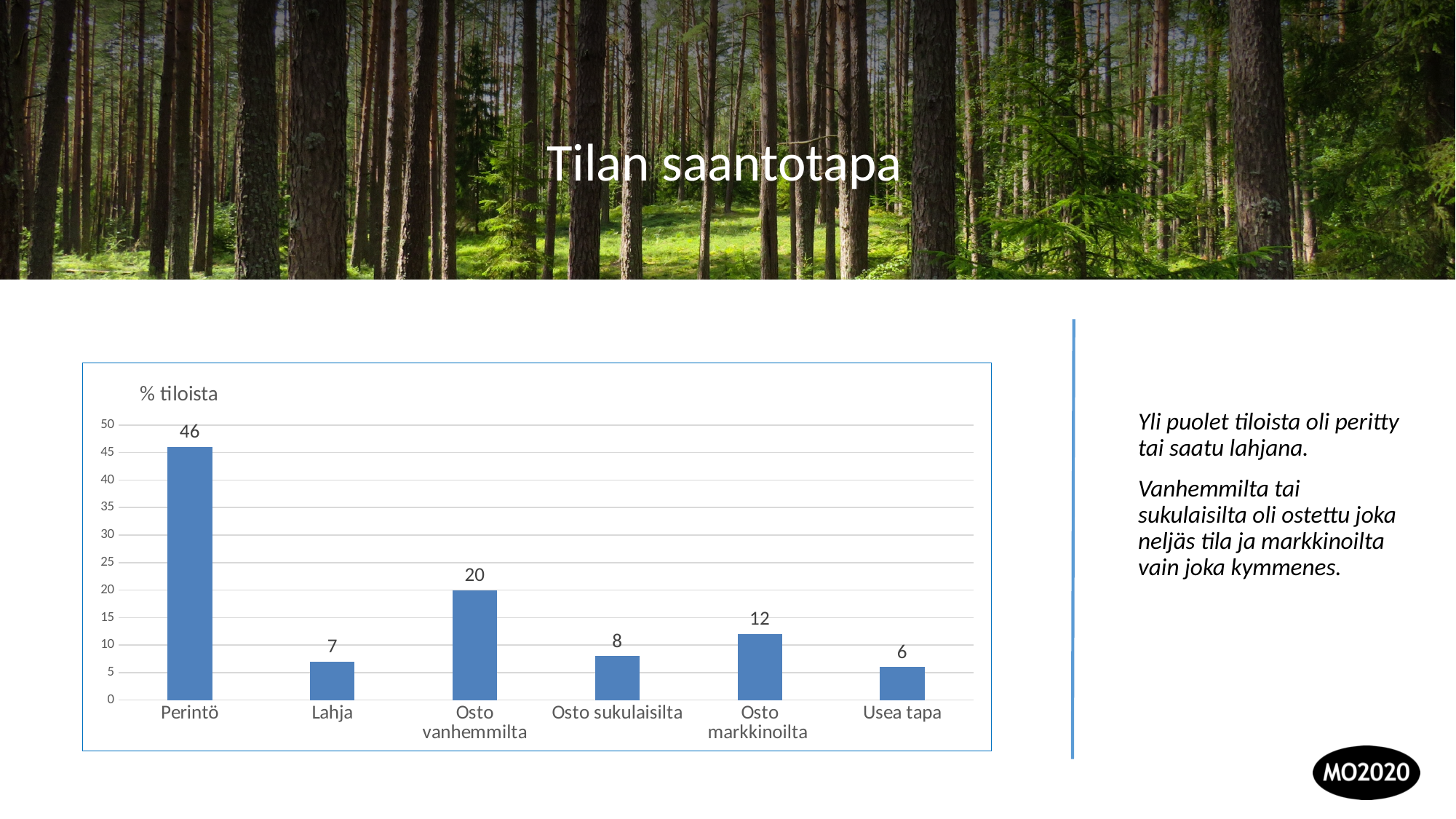
What is the difference between the values for Perintö and Osto vanhemmilta? 26 Which is larger, the value for Lahja or the value for Osto sukulaisilta? Osto sukulaisilta What kind of chart is shown on the slide? Bar chart Which category has the lowest value? Usea tapa What is the value for Osto markkinoilta? 12 What is the value for Usea tapa? 6 What is the difference between the values for Osto markkinoilta and Lahja? 5 How many categories are shown on the x axis? 6 What is the value for Perintö? 46 What is the value for Osto vanhemmilta? 20 What is the title of the chart? % tiloista Which category has the highest value? Perintö